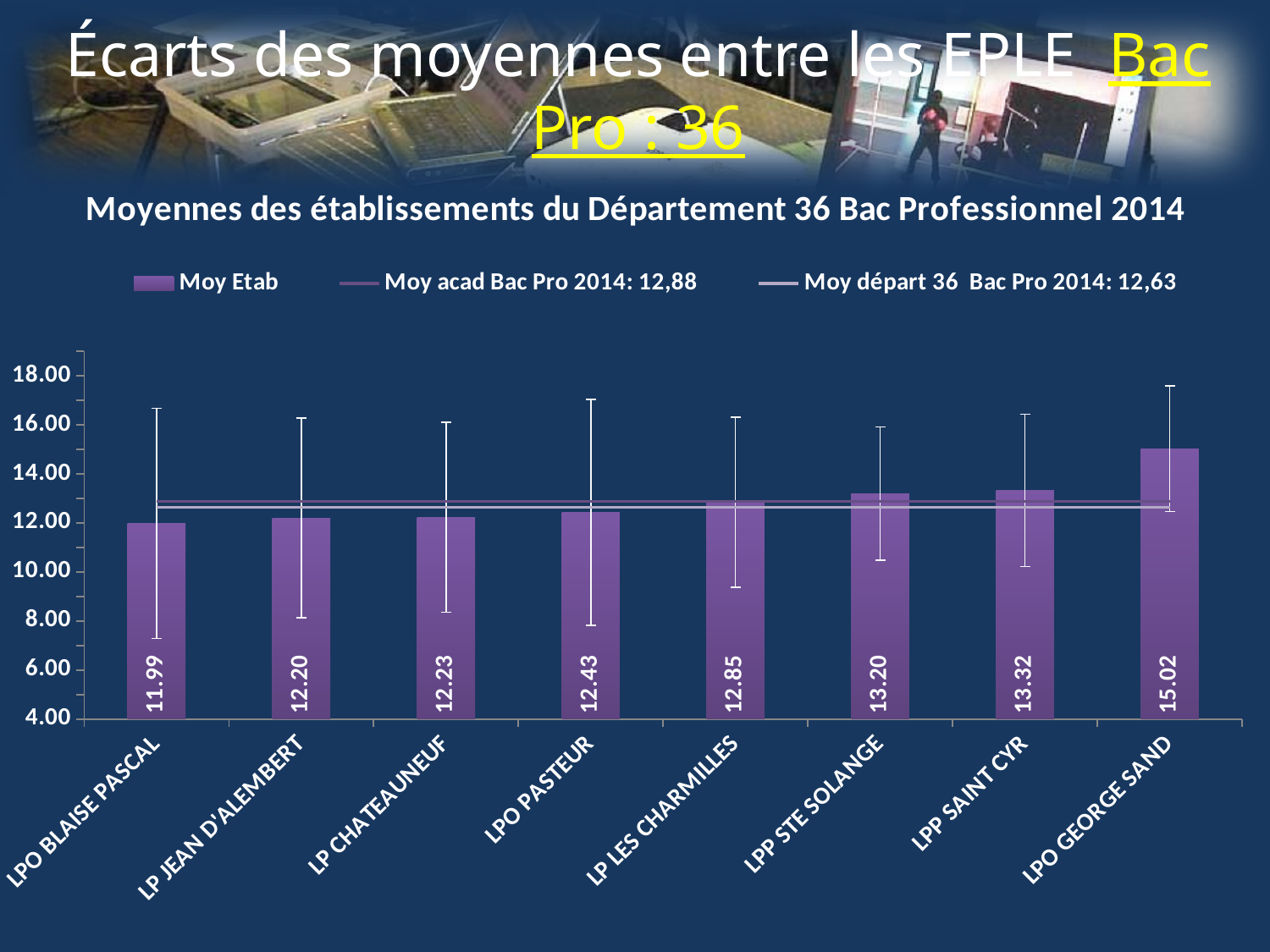
How many establishments are shown on the x axis? 8 What kind of chart is shown? bar chart Which establishment has the highest value? LPO GEORGE SAND What is the title of the chart? Moyennes des établissements du Département 36 Bac Professionnel 2014 Which establishment has the lowest value? LPO BLAISE PASCAL What is the value for LPP STE SOLANGE? 13.20 Which has a larger value, LPP SAINT CYR or LP LES CHARMILLES? LPP SAINT CYR What is the difference between the values for LPO GEORGE SAND and LPO BLAISE PASCAL? 3.03 How many entries does the legend list? 3 What is the value for LPO PASTEUR? 12.43 What is the value for LPO BLAISE PASCAL? 11.99 Is the value for LPO GEORGE SAND greater or less than 14.00? greater